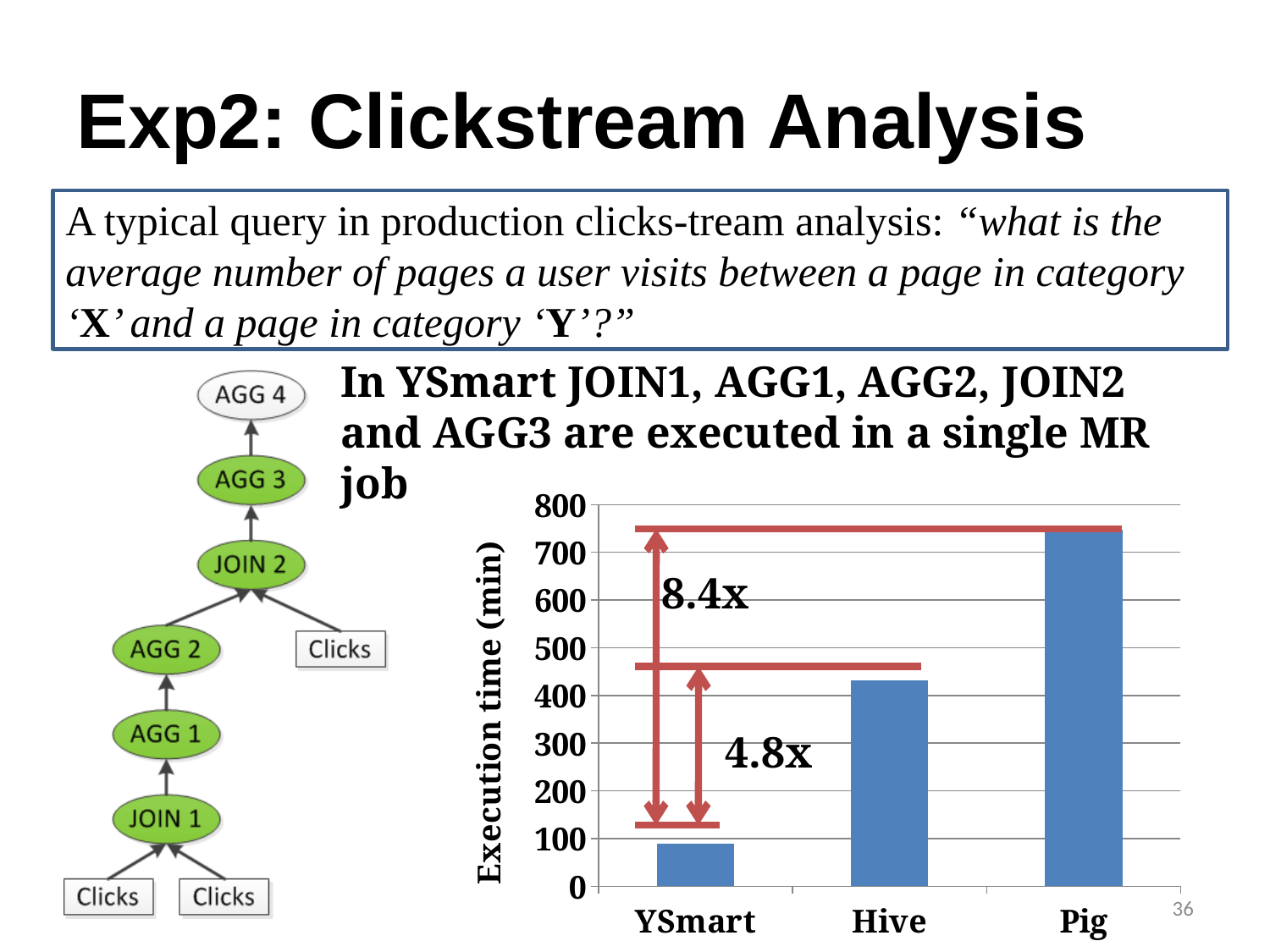
Is the execution time for YSmart greater or less than 100? less What speedup factor is annotated between YSmart and Pig in the chart? 8.4x Which system has the lowest execution time in the chart? YSmart What kind of chart is shown on the slide? bar chart Is the execution time for Pig greater or less than 700? greater Is the execution time for Hive greater or less than 400? greater How many categories are plotted on the x axis of the chart? 3 Which system has the highest execution time in the chart? Pig What is the label of the y axis of the chart? Execution time (min) Which has a larger execution time, YSmart or Hive? Hive Which has a larger execution time, Hive or Pig? Pig